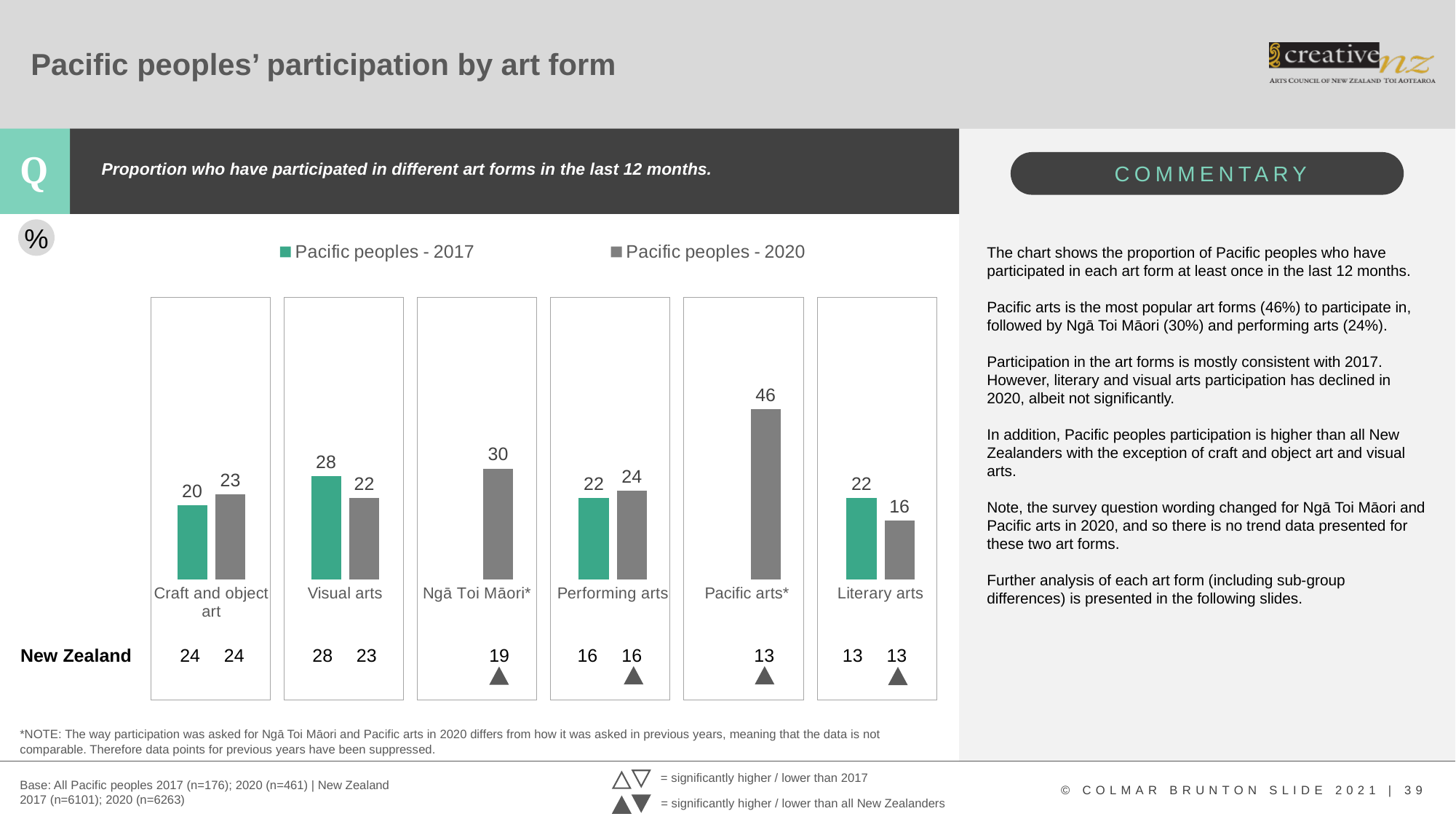
What is the value for Pacific peoples - 2020 for Pacific arts*? 46 What is the value for Pacific peoples - 2020 for Ngā Toi Māori*? 30 Which art form has the highest value for Pacific peoples - 2020? Pacific arts* What is the difference between the Pacific peoples - 2017 and Pacific peoples - 2020 values for Literary arts? 6 Which art form has the lowest value for Pacific peoples - 2020? Literary arts What is the difference between the Pacific peoples - 2017 and Pacific peoples - 2020 values for Visual arts? 6 For Craft and object art, which is larger: the Pacific peoples - 2017 value or the Pacific peoples - 2020 value? Pacific peoples - 2020 What kind of chart is shown on the slide? Bar chart How many series does the legend list? 2 What is the value for Pacific peoples - 2017 for Visual arts? 28 What is the value for Pacific peoples - 2020 for Literary arts? 16 How many art form categories are shown on the chart? 6